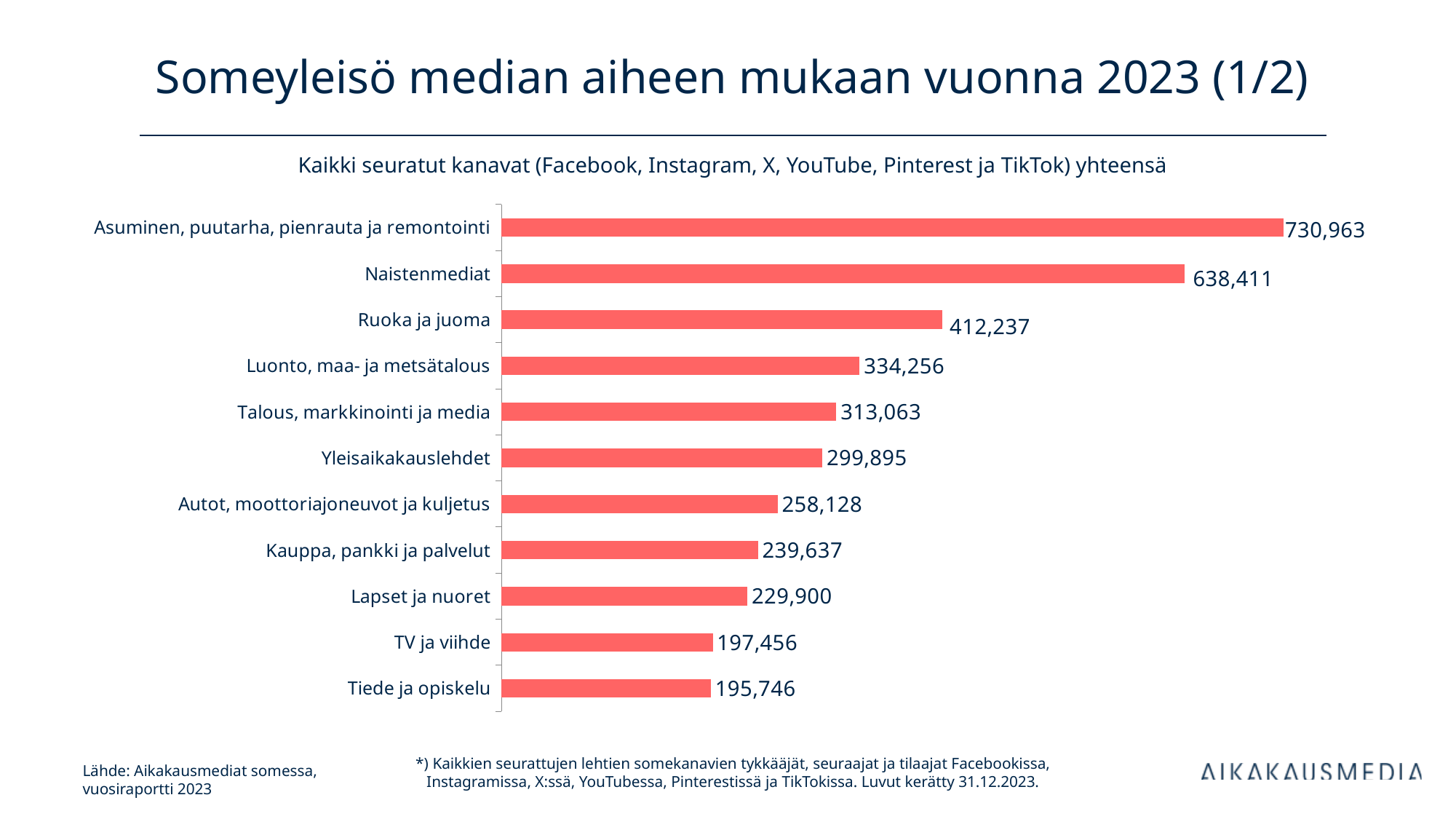
What is the subtitle shown above the chart? Kaikki seuratut kanavat (Facebook, Instagram, X, YouTube, Pinterest ja TikTok) yhteensä How many categories are shown in the chart? 11 What is the value for Naistenmediat? 638,411 What is the difference between the values for Ruoka ja juoma and Luonto, maa- ja metsätalous? 77,981 Which category has the highest value? Asuminen, puutarha, pienrauta ja remontointi What is the difference between the values for Asuminen, puutarha, pienrauta ja remontointi and Naistenmediat? 92,552 Which is larger, the value for Talous, markkinointi ja media or the value for Kauppa, pankki ja palvelut? Talous, markkinointi ja media What is the value for Autot, moottoriajoneuvot ja kuljetus? 258,128 What is the value for Lapset ja nuoret? 229,900 What kind of chart is shown on the slide? Bar chart What is the difference between the values for TV ja viihde and Tiede ja opiskelu? 1,710 Which category has the lowest value? Tiede ja opiskelu